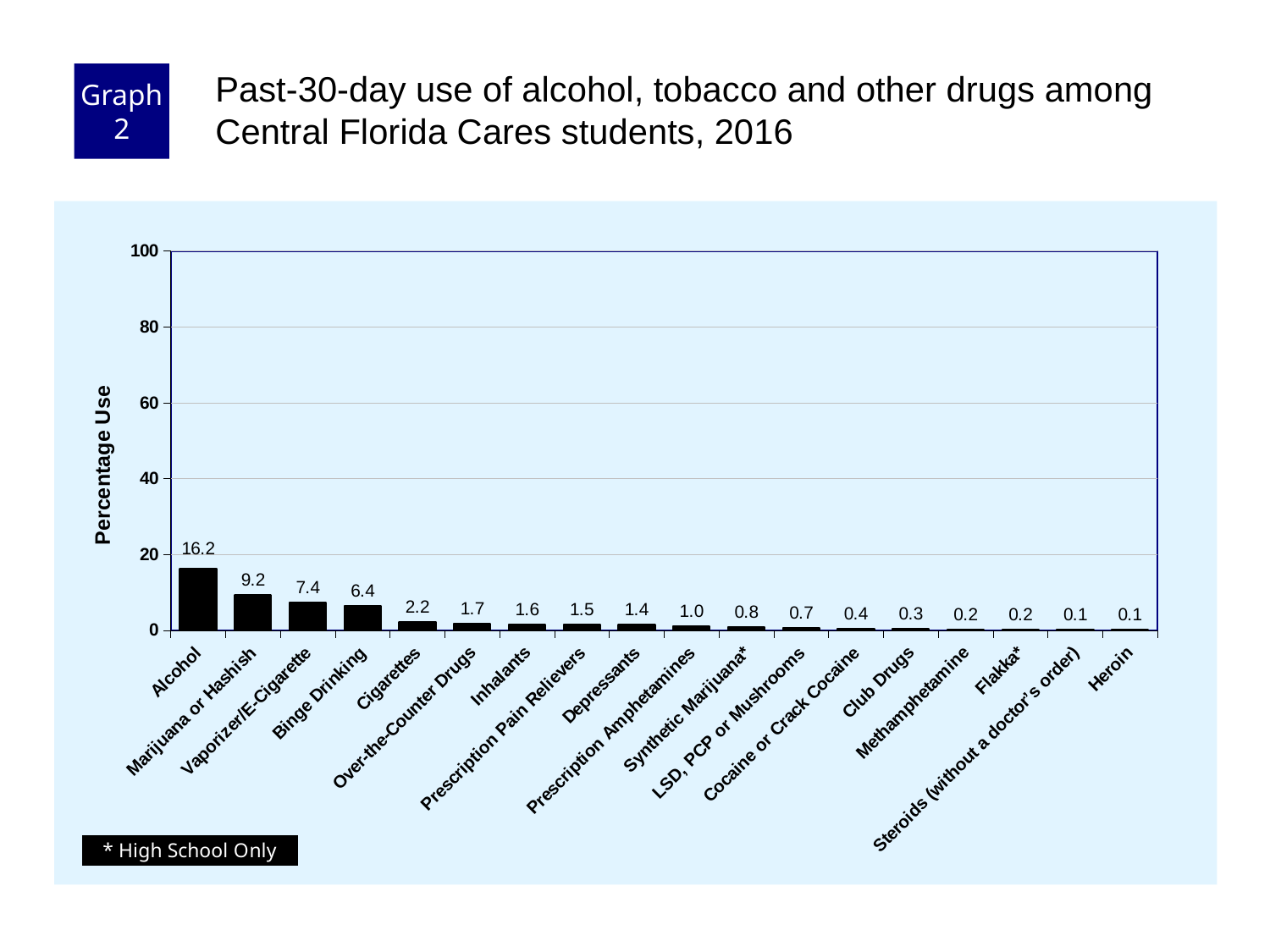
What is the percentage use for Inhalants? 1.6 What is the label of the y axis? Percentage Use What is the difference in percentage use between Alcohol and Marijuana or Hashish? 7.0 Is the value for Alcohol greater or less than 20? less Which has a higher percentage use, Vaporizer/E-Cigarette or Binge Drinking? Vaporizer/E-Cigarette How many categories are shown on the x axis? 18 What is the percentage use for Alcohol? 16.2 What is the difference in percentage use between Cigarettes and Over-the-Counter Drugs? 0.5 What is the percentage use for Binge Drinking? 6.4 What kind of chart is shown on the slide? bar chart What is the percentage use for Cocaine or Crack Cocaine? 0.4 Which category has the highest percentage use? Alcohol